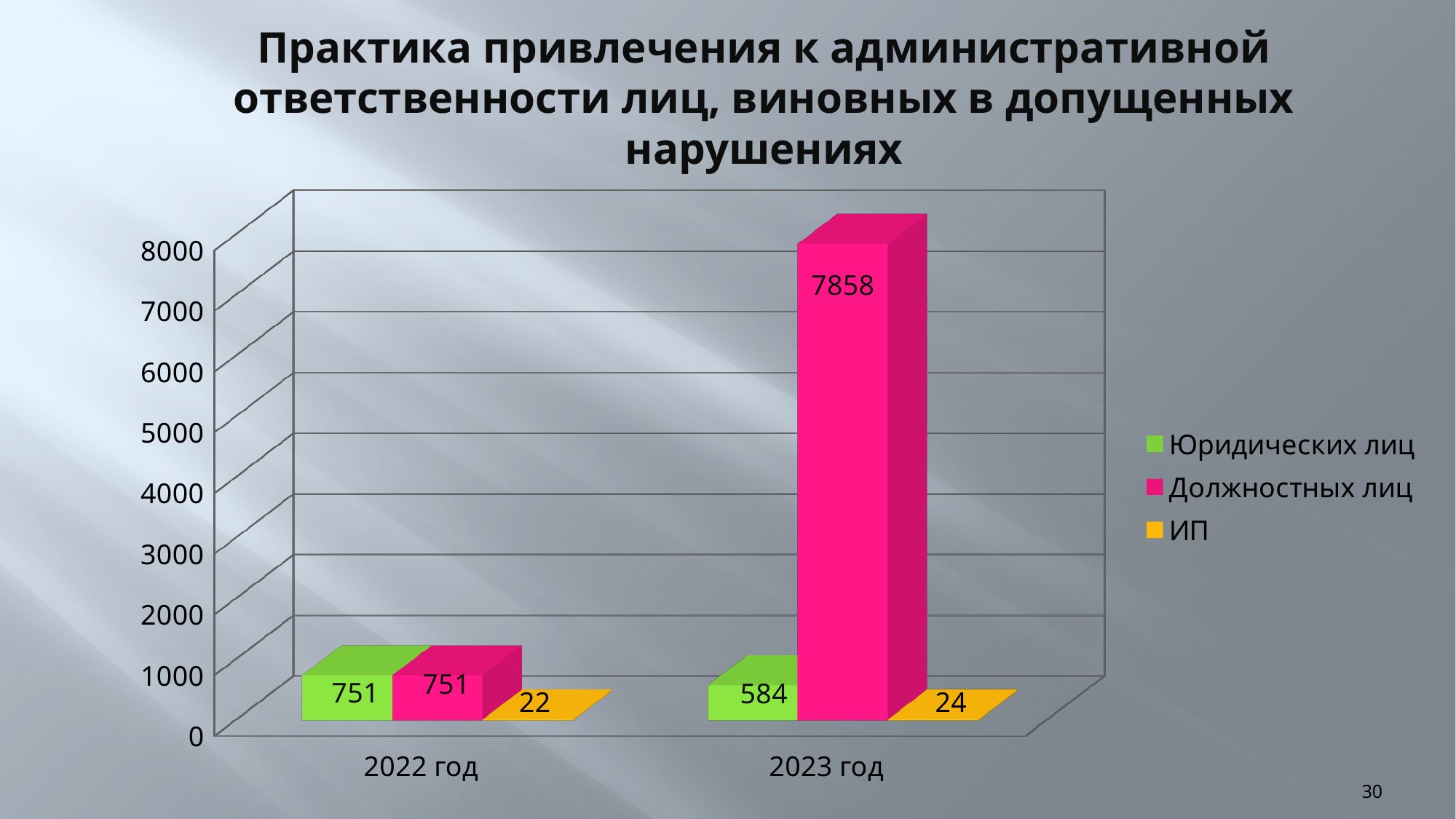
Which series has the highest value in 2023 год? Должностных лиц How many categories are shown on the x axis? 2 What is the difference between the Должностных лиц values for 2023 год and 2022 год? 7107 Does the value for Юридических лиц rise or fall from 2022 год to 2023 год? fall Which is larger: the Юридических лиц value for 2022 год or for 2023 год? 2022 год Which series has the lowest value in 2022 год? ИП What is the value for Юридических лиц in 2023 год? 584 What is the value for Должностных лиц in 2023 год? 7858 What is the value for ИП in 2023 год? 24 What is the value for Юридических лиц in 2022 год? 751 What type of chart is shown on the slide? bar chart How many series does the legend list? 3